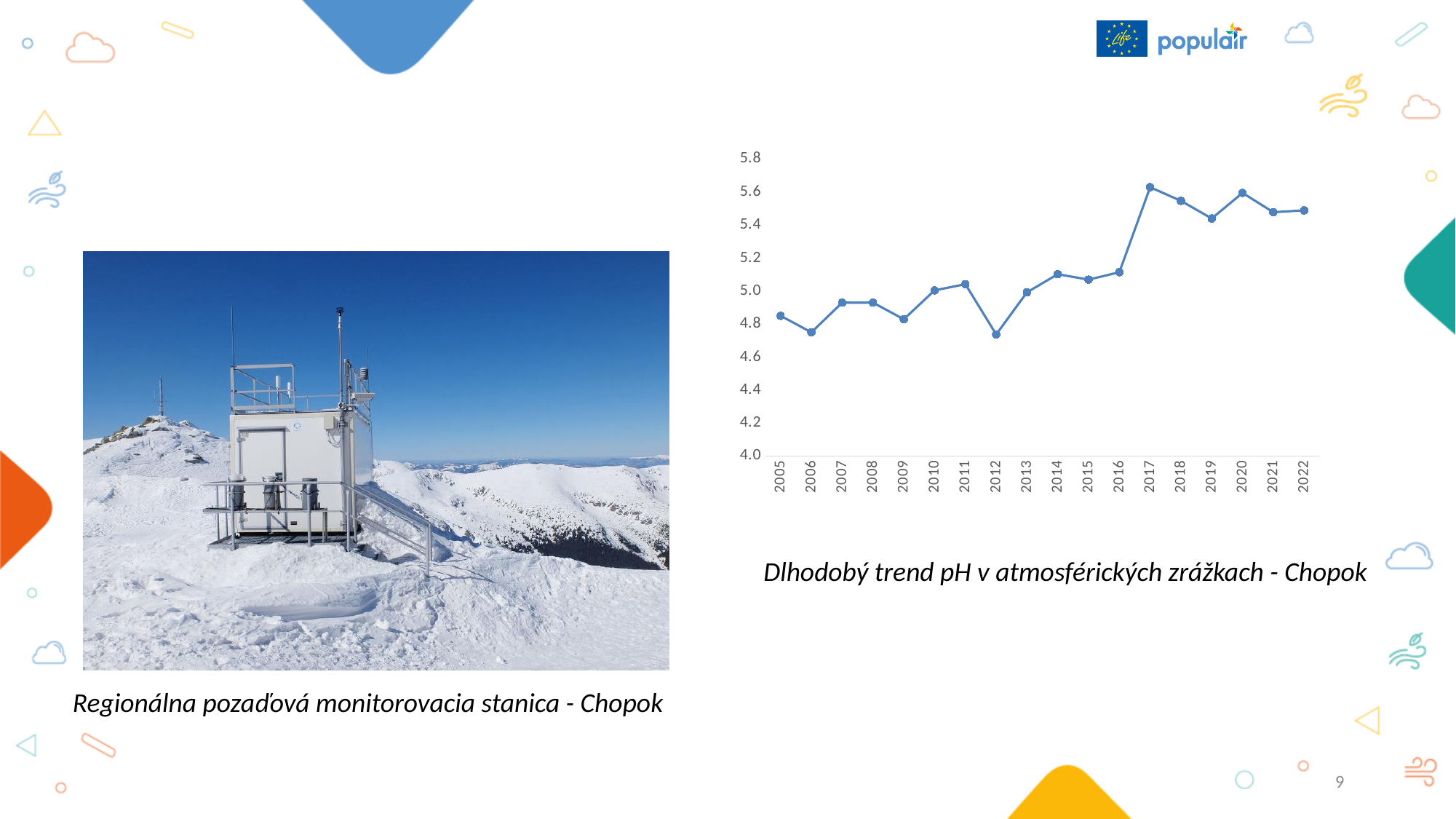
Which year has the larger value, 2006 or 2010? 2010 What is the last year shown on the x axis of the chart? 2022 Overall, do the pH values rise or fall from 2005 to 2022? rise What kind of chart is shown on the slide? line chart How many years (data points) are plotted on the chart? 18 Is the value for 2017 greater or less than 5.4? greater Is the value for 2006 greater or less than 4.8? less Is the value for 2012 greater or less than 4.8? less What is the first year shown on the x axis of the chart? 2005 Which year has the larger value, 2017 or 2012? 2017